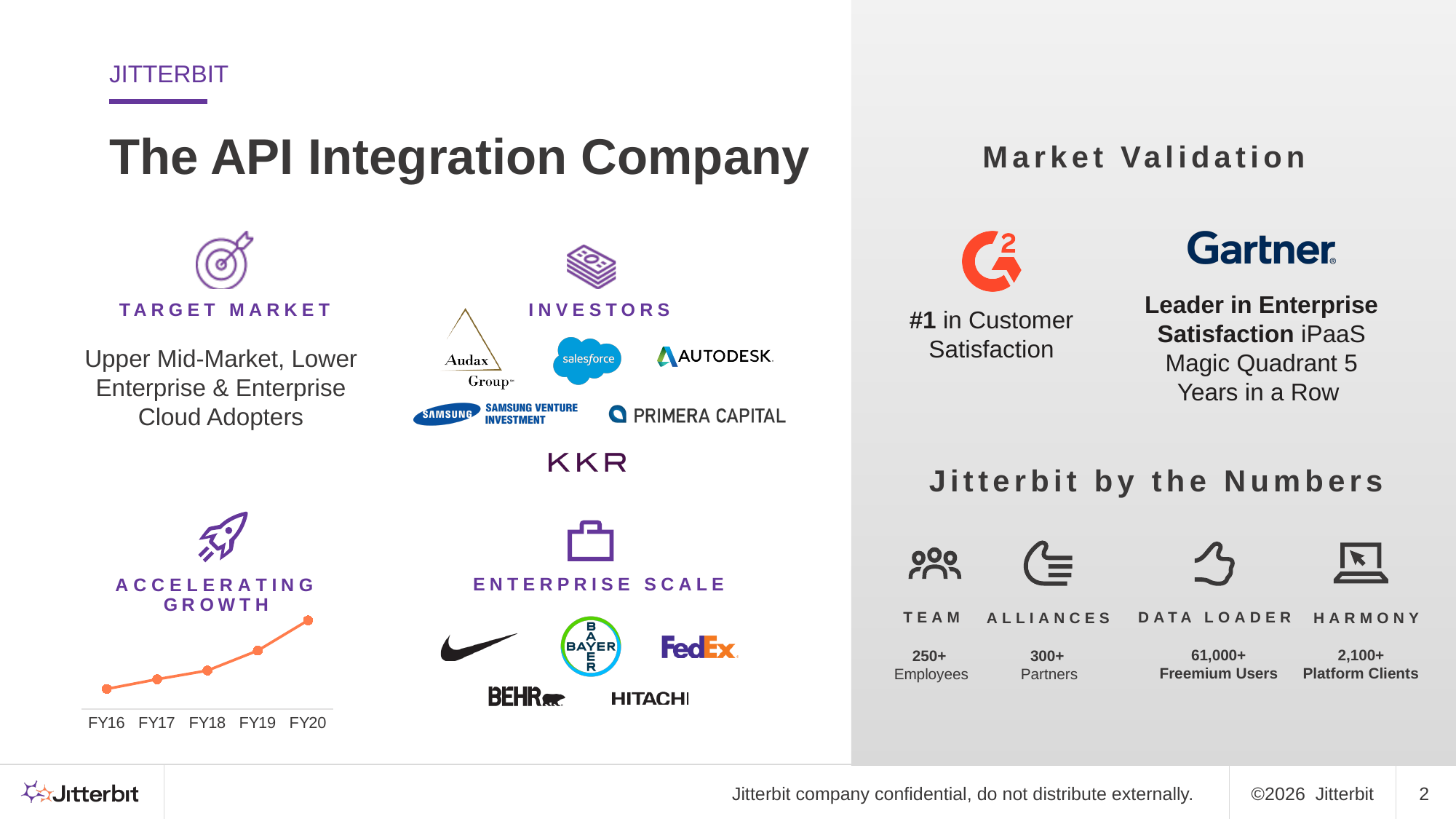
Do the values on the Accelerating Growth chart rise or fall from FY16 to FY20? rise On the Accelerating Growth chart, is the value for FY20 larger or smaller than the value for FY16? larger What is the first fiscal year shown on the x axis of the Accelerating Growth chart? FY16 Which fiscal year has the lowest value on the Accelerating Growth chart? FY16 How many data points are plotted on the Accelerating Growth line chart? 5 What kind of chart is shown under the "Accelerating Growth" heading? line chart Which fiscal years are shown on the x axis of the Accelerating Growth chart? FY16, FY17, FY18, FY19, FY20 On the Accelerating Growth chart, which is larger, the value for FY19 or the value for FY17? FY19 On the Accelerating Growth chart, is the value for FY18 larger or smaller than the value for FY20? smaller Which fiscal year has the highest value on the Accelerating Growth chart? FY20